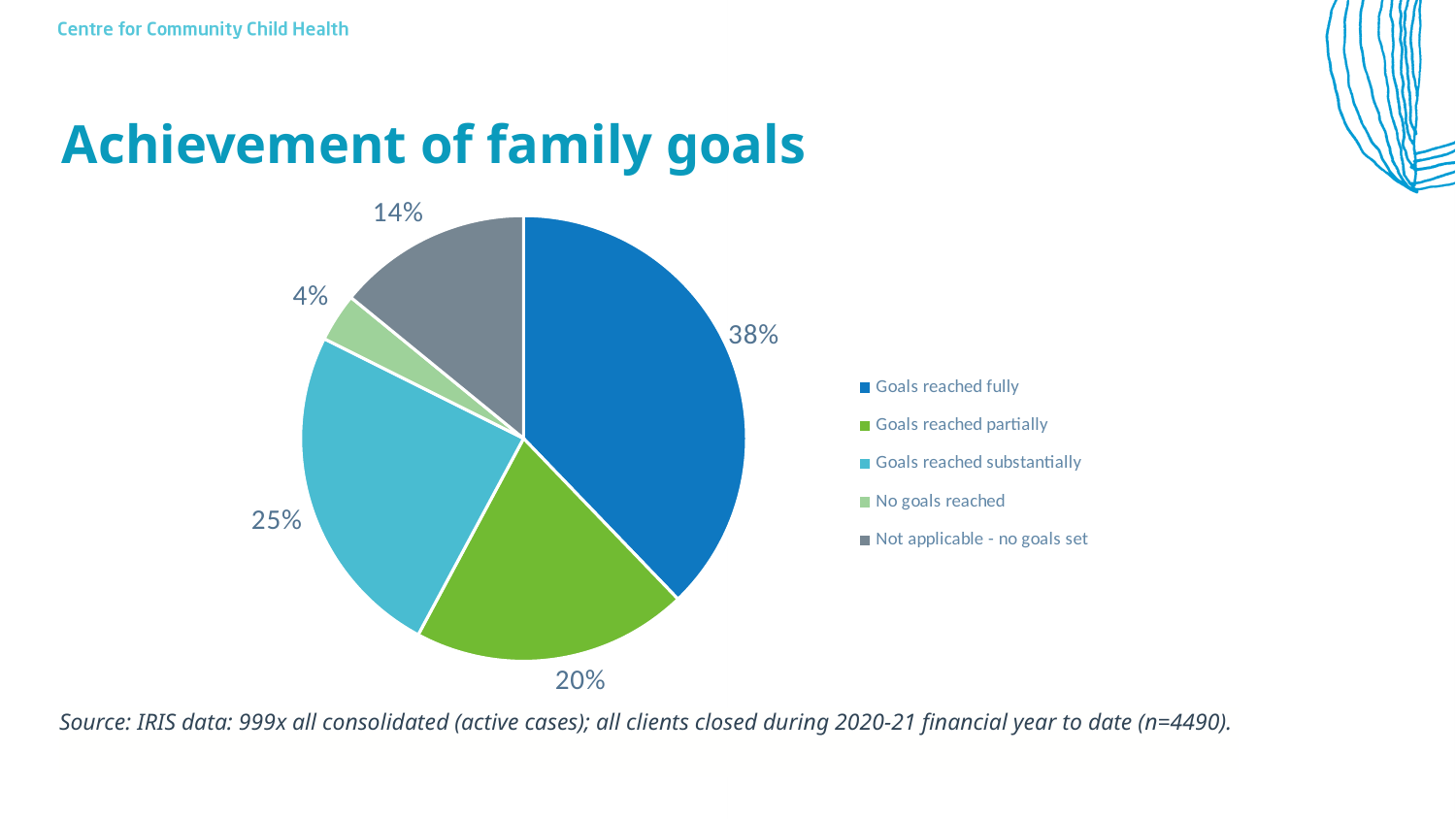
What percentage is shown for 'No goals reached'? 4% Which category has the largest slice of the pie? Goals reached fully How many categories does the pie chart show? 5 Which is larger: 'Goals reached substantially' or 'Not applicable - no goals set'? Goals reached substantially Which category has the smallest slice of the pie? No goals reached What type of chart is shown on the slide? Pie chart What percentage is shown for 'Goals reached substantially'? 25% What share of the pie is labelled 'Goals reached fully'? 38% What percentage is shown for 'Goals reached partially'? 20% What is the title of the slide containing the chart? Achievement of family goals What percentage is shown for 'Not applicable - no goals set'? 14% What is the difference in percentage points between 'Goals reached fully' and 'Goals reached partially'? 18